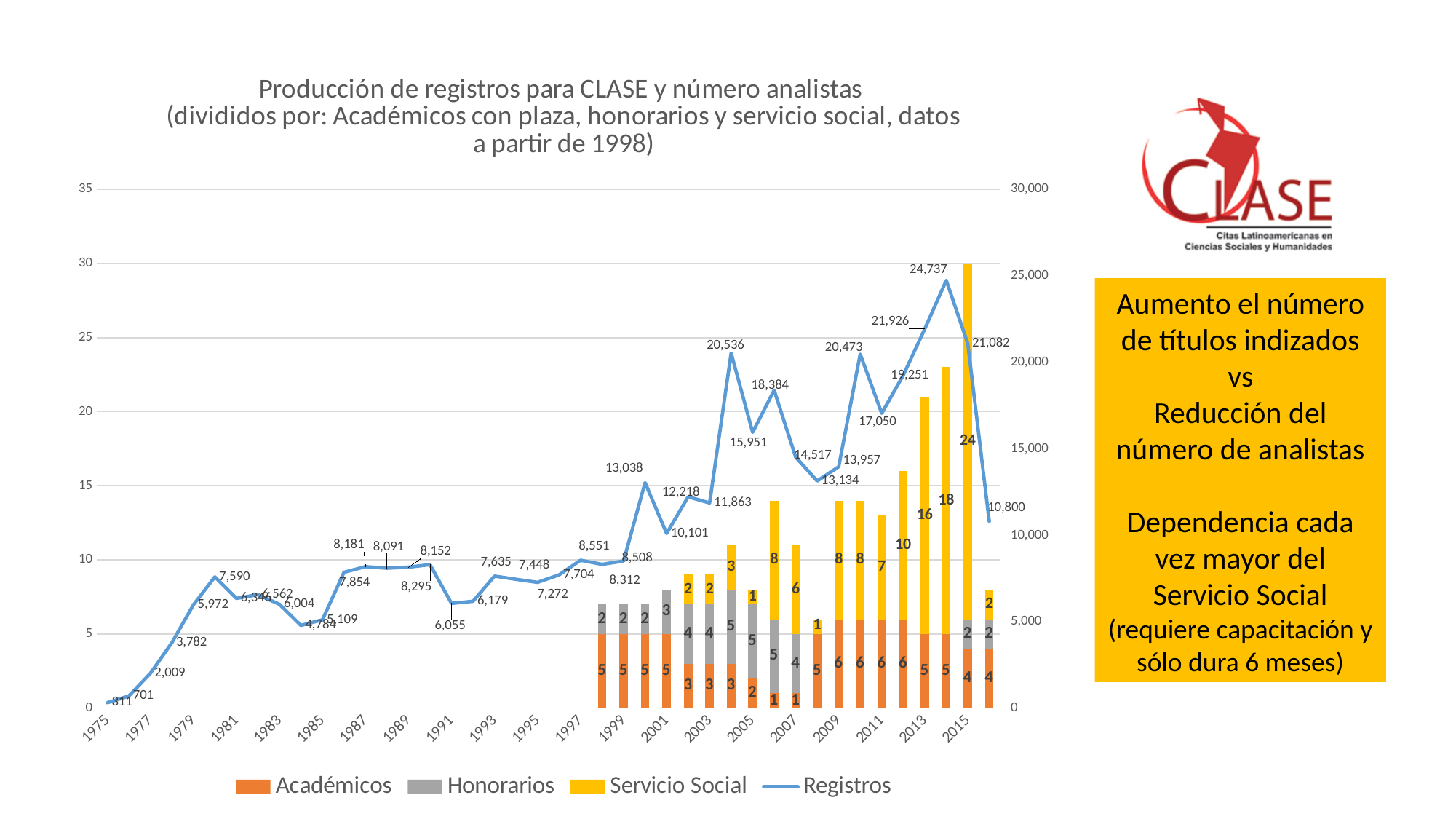
How many series does the legend list? 4 What kind of chart is shown on the slide? A combined bar and line chart (stacked bars with a line) What is the lowest value of the Registros line? 311 Which is larger, the Registros value of 20,536 or the Registros value of 20,473? 20,536 Which series is shown in yellow in the legend? Servicio Social What is the total of the stacked bar at 2015 (Académicos 4, Honorarios 2, Servicio Social 24)? 30 What is the largest Servicio Social value shown on any bar? 24 What is the value of Registros at the last point of the line (2016)? 10,800 Is the peak Registros value greater or less than 20,000? greater What is the highest value of the Registros line? 24,737 What is the value of Registros in 1975? 311 What is the difference between the peak Registros value of 24,737 and the following value of 21,082? 3,655